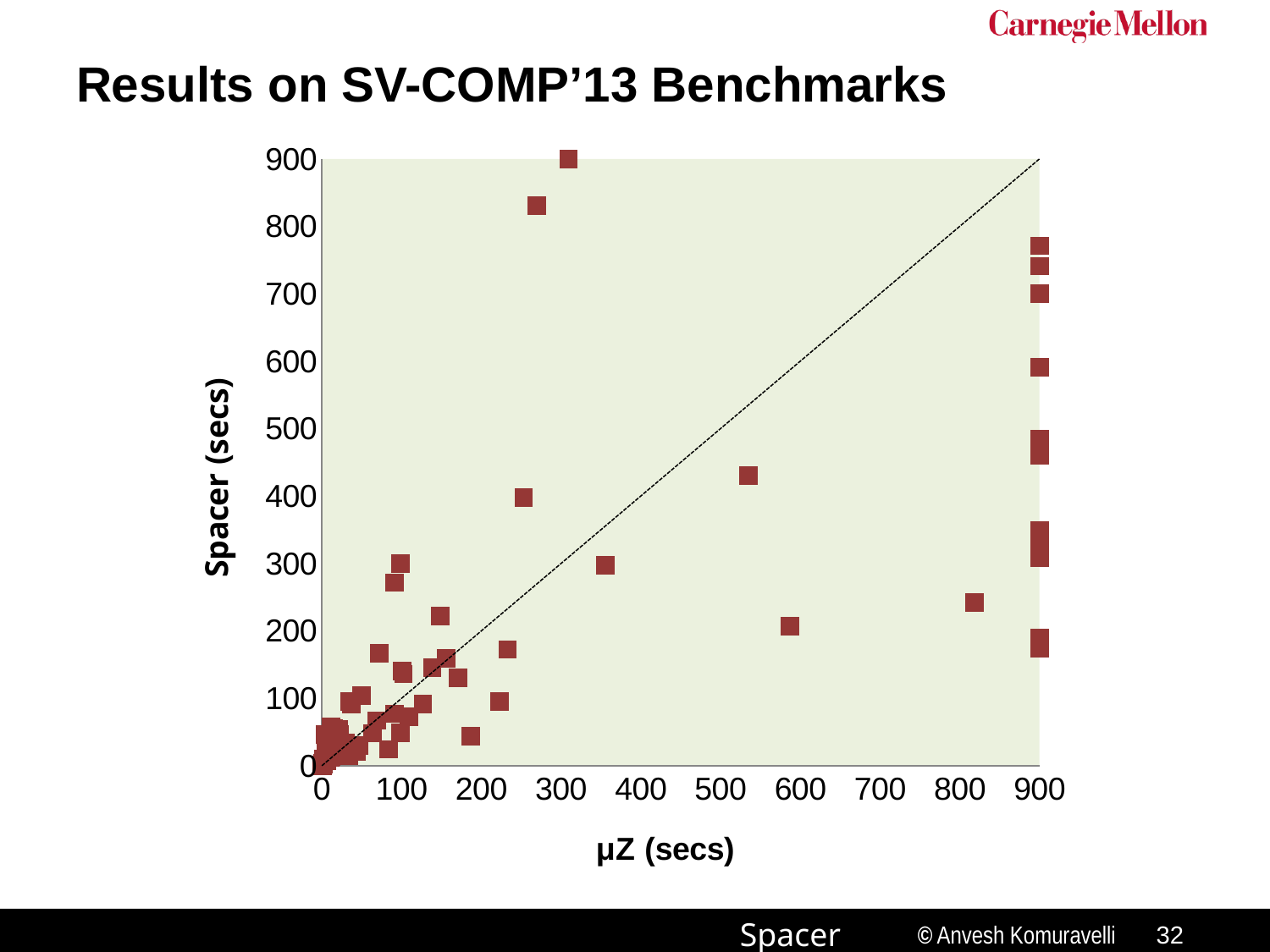
Is the μZ time of the rightmost column of plotted points greater or less than 800? greater Is the Spacer time of the highest plotted point greater or less than 800? greater What kind of chart is shown on the slide? scatter plot What is the label of the y axis of the chart? Spacer (secs) Is the Spacer time of the lowest point in the rightmost column of plotted points greater or less than 100? greater What is the label of the x axis of the chart? μZ (secs)